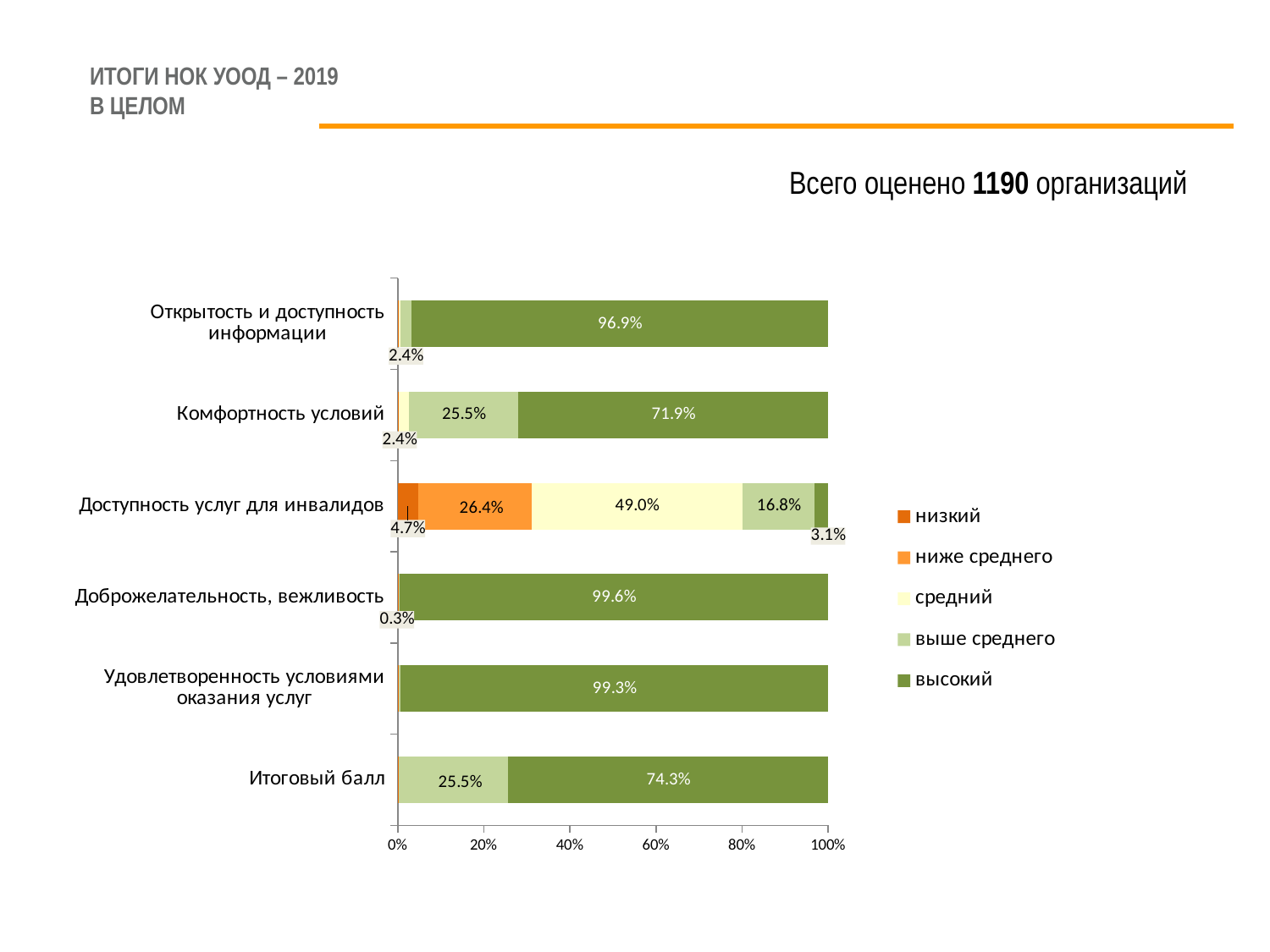
What is the difference between the 'высокий' values for 'Итоговый балл' and 'Комфортность условий'? 2.4 percentage points What is the value of the 'высокий' segment for 'Открытость и доступность информации'? 96.9% Which category has the lowest 'высокий' value? Доступность услуг для инвалидов What is the value of the 'средний' segment for 'Доступность услуг для инвалидов'? 49.0% What is the value of the 'ниже среднего' segment for 'Доступность услуг для инвалидов'? 26.4% How many categories are plotted on the chart? 6 How many series does the legend list? 5 Which category has the highest 'высокий' value? Доброжелательность, вежливость What is the value of the 'высокий' segment for 'Итоговый балл'? 74.3% Which has the larger 'высокий' value: 'Комфортность условий' or 'Итоговый балл'? Итоговый балл What is the value of the 'выше среднего' segment for 'Доступность услуг для инвалидов'? 16.8% What kind of chart is shown on the slide? stacked bar chart